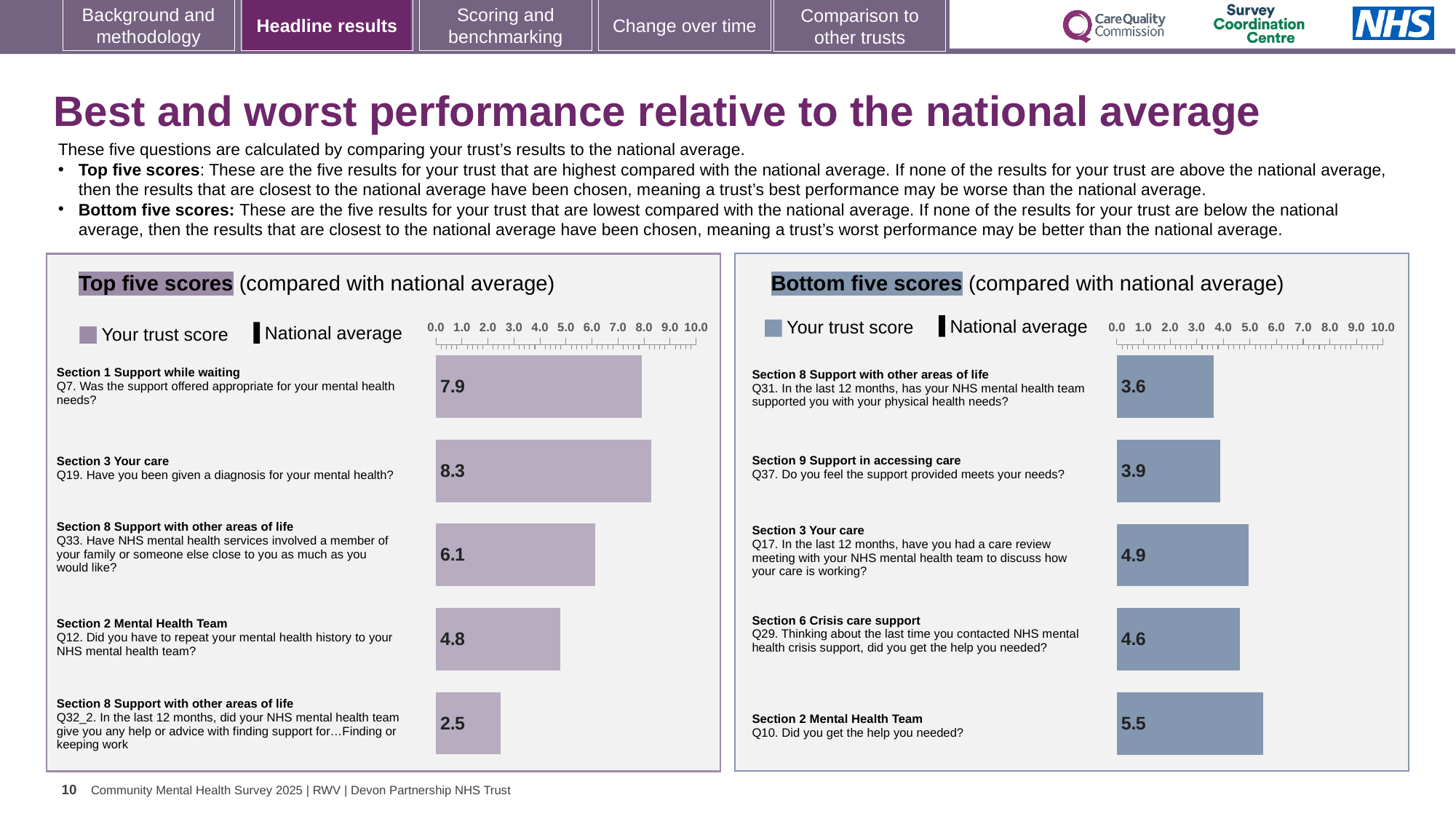
In the Bottom five scores chart, what is the trust score for Q31 (supported you with your physical health needs?)? 3.6 How many questions are plotted in the Bottom five scores chart? 5 In the Top five scores chart, what is the trust score for Q19 (Have you been given a diagnosis for your mental health?)? 8.3 In the Top five scores chart, which question has the lowest trust score? Q32_2 In the Bottom five scores chart, what is the trust score for Q10 (Did you get the help you needed?)? 5.5 In the Top five scores chart, which question has the highest trust score? Q19 What kind of chart is the Top five scores chart? Bar chart In the Top five scores chart, what is the difference between the trust scores for Q19 and Q32_2? 5.8 In the Bottom five scores chart, which question has the highest trust score? Q10 In the Top five scores chart, what is the trust score for Q7 (Was the support offered appropriate for your mental health needs?)? 7.9 In the Bottom five scores chart, which has the larger trust score, Q17 or Q29? Q17 In the Bottom five scores chart, which question has the lowest trust score? Q31